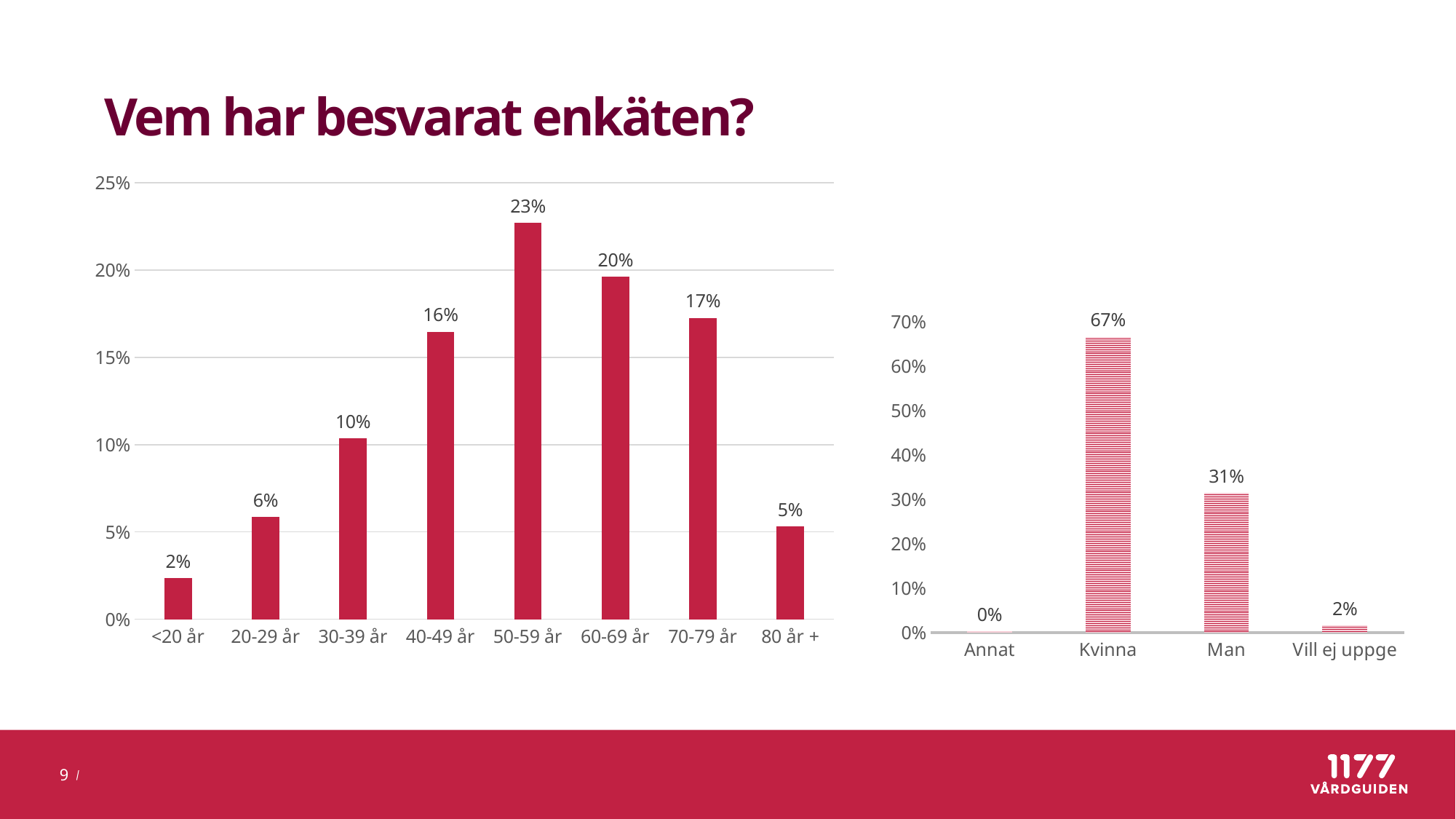
In the right chart (gender), what is the difference between the values for Kvinna and Man? 36% In the right chart (gender), what is the value for Man? 31% In the left chart (age groups), which age group has the highest value? 50-59 år In the left chart (age groups), what is the value for 50-59 år? 23% In the left chart (age groups), which age group has the lowest value? <20 år In the right chart (gender), what is the value for Kvinna? 67% What kind of chart is the right chart (gender)? Bar chart In the left chart (age groups), which is larger, the value for 70-79 år or the value for 30-39 år? 70-79 år In the left chart (age groups), what is the difference between the values for 60-69 år and 40-49 år? 4% In the left chart (age groups), how many age groups are shown? 8 In the left chart (age groups), what is the value for <20 år? 2% In the right chart (gender), how many categories are shown? 4